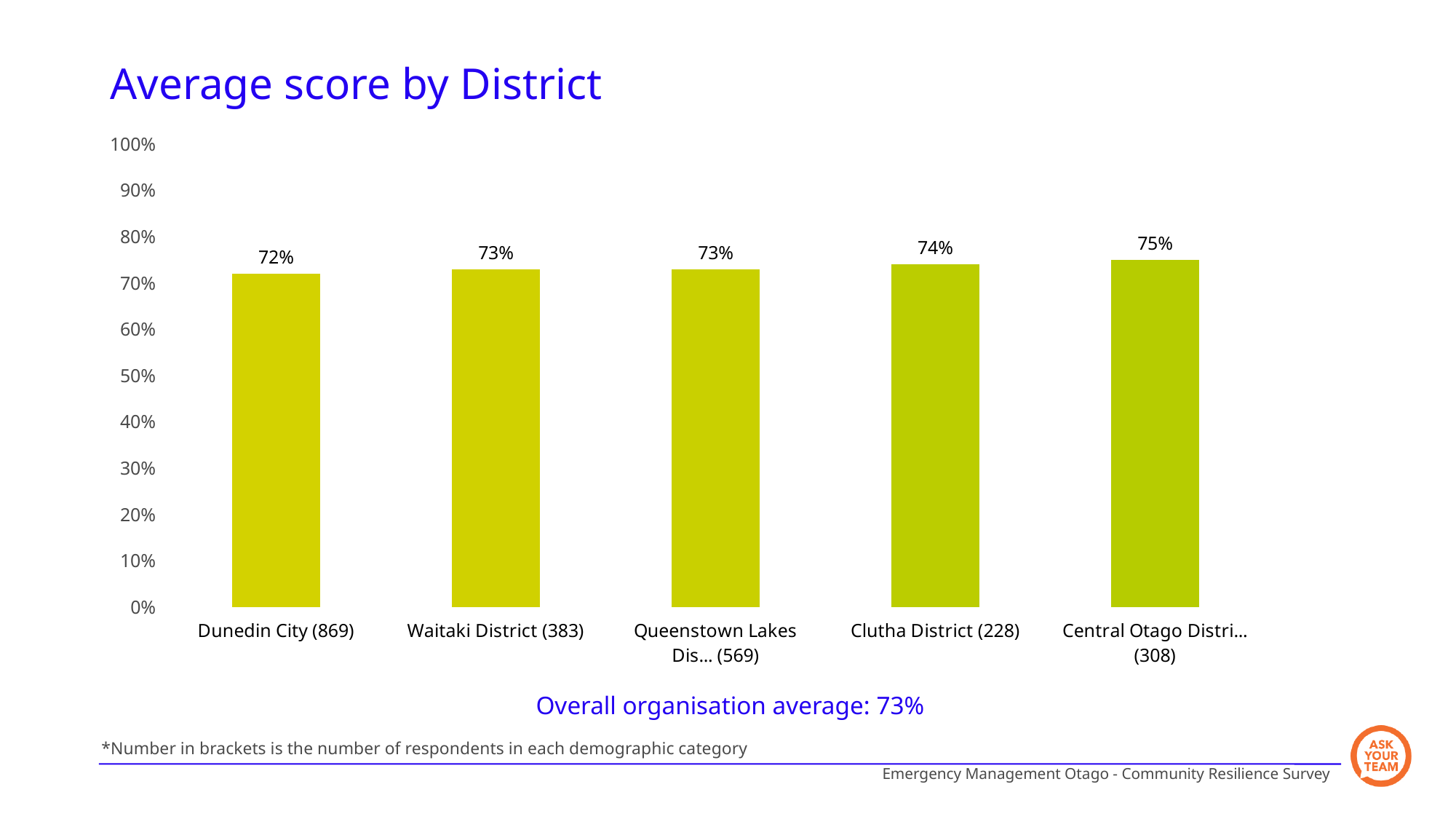
Which district has the highest average score? Central Otago District (308) What is the average score for Waitaki District (383)? 73% What is the overall organisation average stated on the slide? 73% What is the difference between the average score for Central Otago District (308) and Dunedin City (869)? 3% What is the average score for Dunedin City (869)? 72% Which district has the lowest average score? Dunedin City (869) How many districts are shown in the chart? 5 Do the average scores rise or fall from left to right across the districts? Rise What kind of chart is shown on the slide? Bar chart Is the value for Central Otago District (308) greater or less than 70%? greater Which has a higher average score, Clutha District (228) or Waitaki District (383)? Clutha District (228) What is the average score for Clutha District (228)? 74%